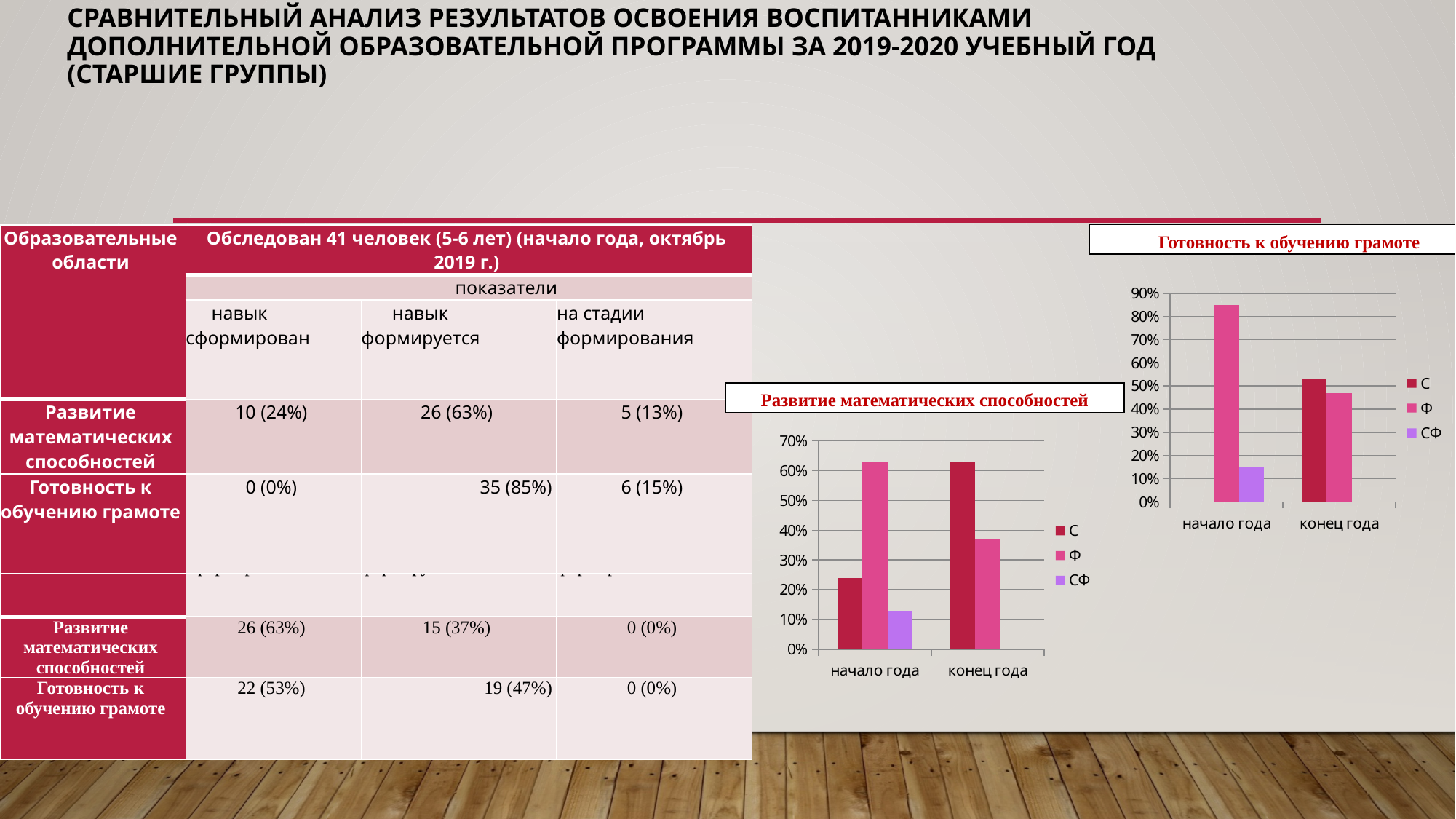
How many categories are shown on the x axis of the 'Готовность к обучению грамоте' chart? 2 What kind of chart is the 'Развитие математических способностей' chart? bar chart In the 'Развитие математических способностей' chart, does the value for Ф rise or fall from 'начало года' to 'конец года'? falls In the 'Развитие математических способностей' chart, does the value for С rise or fall from 'начало года' to 'конец года'? rises In the 'Готовность к обучению грамоте' chart, is the value for Ф at 'начало года' greater or less than 80%? greater In the 'Готовность к обучению грамоте' chart, which series has the highest value at 'начало года'? Ф In the 'Развитие математических способностей' chart, which is larger at 'конец года': С or Ф? С In the 'Развитие математических способностей' chart, is the value for С at 'начало года' greater or less than 30%? less How many series does the legend of the 'Развитие математических способностей' chart list? 3 In the 'Готовность к обучению грамоте' chart, is the value for СФ at 'начало года' greater or less than 20%? less What are the legend entries of the 'Готовность к обучению грамоте' chart? С, Ф, СФ